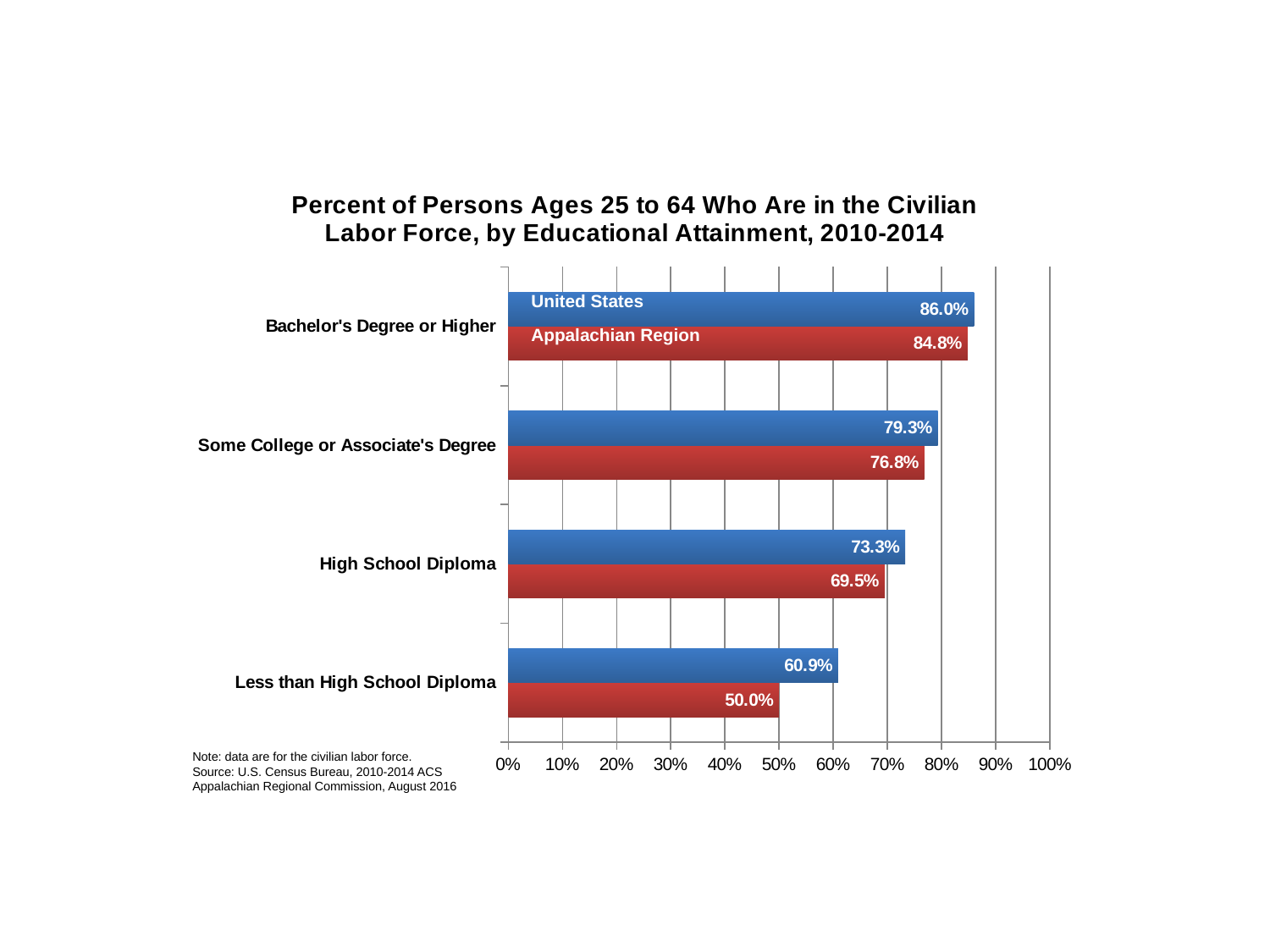
How many educational attainment categories are shown in the chart? 4 What is the difference between the United States and Appalachian Region values for High School Diploma? 3.8% What is the Appalachian Region value for Less than High School Diploma? 50.0% What is the difference between the United States and Appalachian Region values for Less than High School Diploma? 10.9% Which is larger for Some College or Associate's Degree: the United States value or the Appalachian Region value? United States What kind of chart is shown on the slide? Bar chart Which educational attainment category has the highest United States value? Bachelor's Degree or Higher What is the Appalachian Region value for Some College or Associate's Degree? 76.8% What is the United States value for Bachelor's Degree or Higher? 86.0% Which educational attainment category has the lowest Appalachian Region value? Less than High School Diploma How many series does the chart show? 2 What is the United States value for High School Diploma? 73.3%